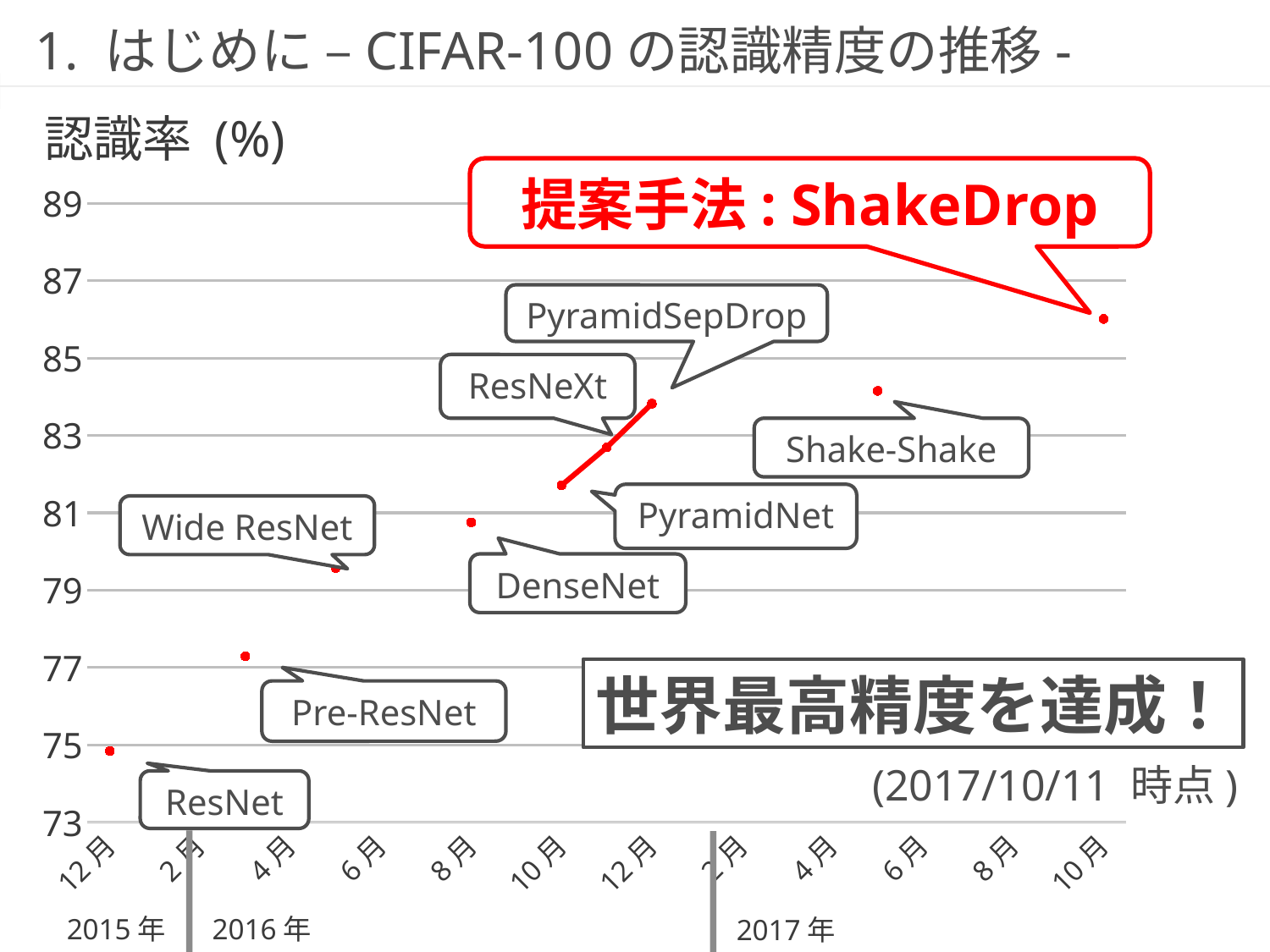
How many methods (data points) are plotted on the chart? 9 Which has the higher recognition accuracy, ShakeDrop or Shake-Shake? ShakeDrop Which method has the highest recognition accuracy on the chart? ShakeDrop Which method has the lowest recognition accuracy on the chart? ResNet Is the value for ShakeDrop greater or less than 85? greater Which has the higher recognition accuracy, DenseNet or Wide ResNet? DenseNet Do the recognition accuracy values rise or fall over time along the x axis? rise Is the value for Shake-Shake greater or less than 85? less Is the value for ShakeDrop greater or less than 87? less